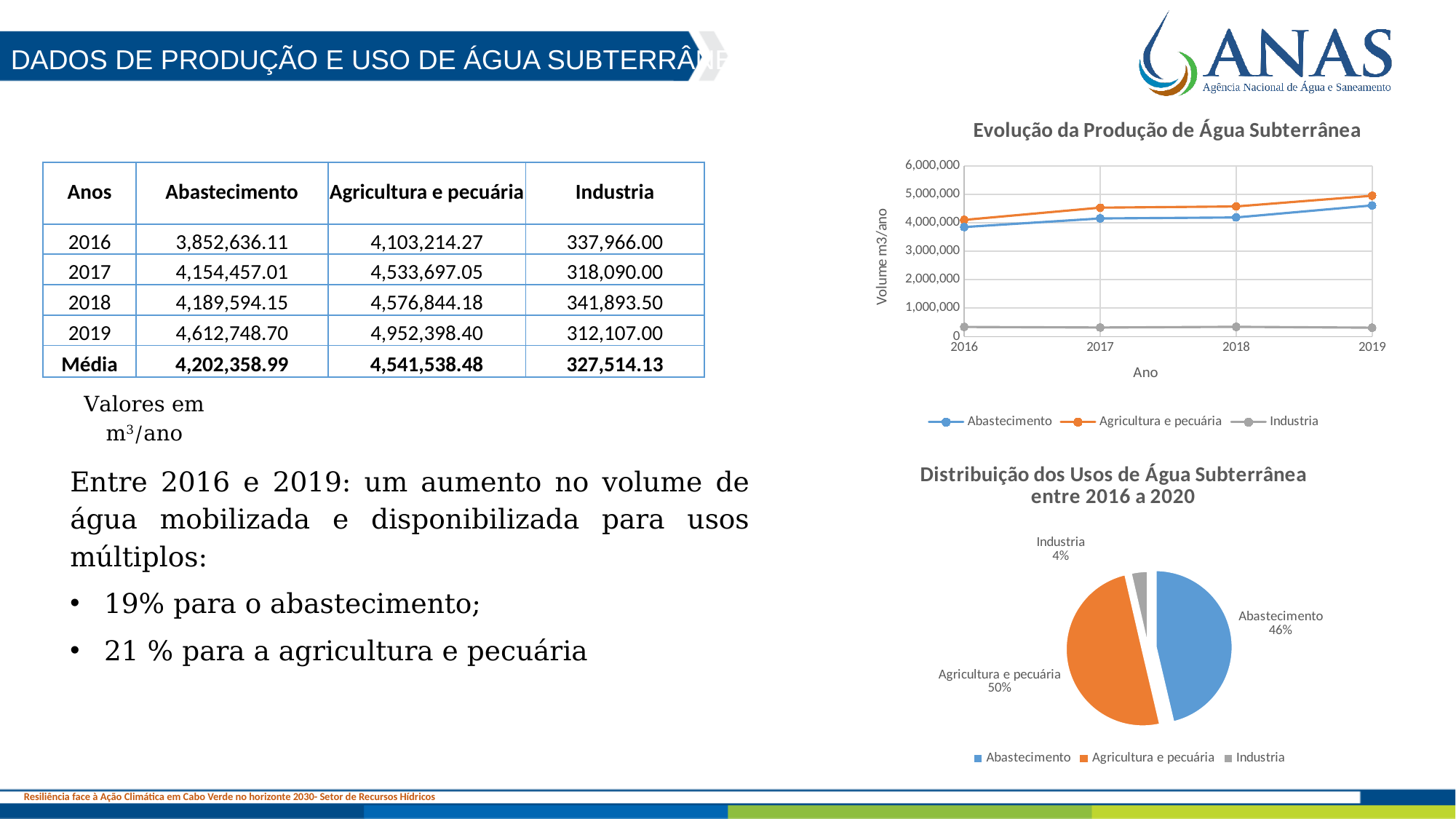
In the 'Distribuição dos Usos de Água Subterrânea entre 2016 a 2020' pie chart, what is the difference between the Abastecimento share and the Industria share? 42% What kind of chart is 'Evolução da Produção de Água Subterrânea'? line chart In the 'Distribuição dos Usos de Água Subterrânea entre 2016 a 2020' pie chart, what share does Agricultura e pecuária have? 50% In the 'Evolução da Produção de Água Subterrânea' chart, which series has the lowest values across all years? Industria In the 'Evolução da Produção de Água Subterrânea' chart, which series has the highest value in 2019? Agricultura e pecuária In the 'Evolução da Produção de Água Subterrânea' chart, is the value for Abastecimento in 2019 greater or less than 4,000,000? greater In the 'Evolução da Produção de Água Subterrânea' chart, is the value for Industria in 2018 greater or less than 1,000,000? less In the 'Evolução da Produção de Água Subterrânea' chart, how many years are plotted on the x axis? 4 In the 'Distribuição dos Usos de Água Subterrânea entre 2016 a 2020' pie chart, what share does Industria have? 4% In the 'Evolução da Produção de Água Subterrânea' chart, does the Abastecimento series rise or fall from 2016 to 2019? rise In the 'Evolução da Produção de Água Subterrânea' chart, how many series does the legend list? 3 What kind of chart is 'Distribuição dos Usos de Água Subterrânea entre 2016 a 2020'? pie chart